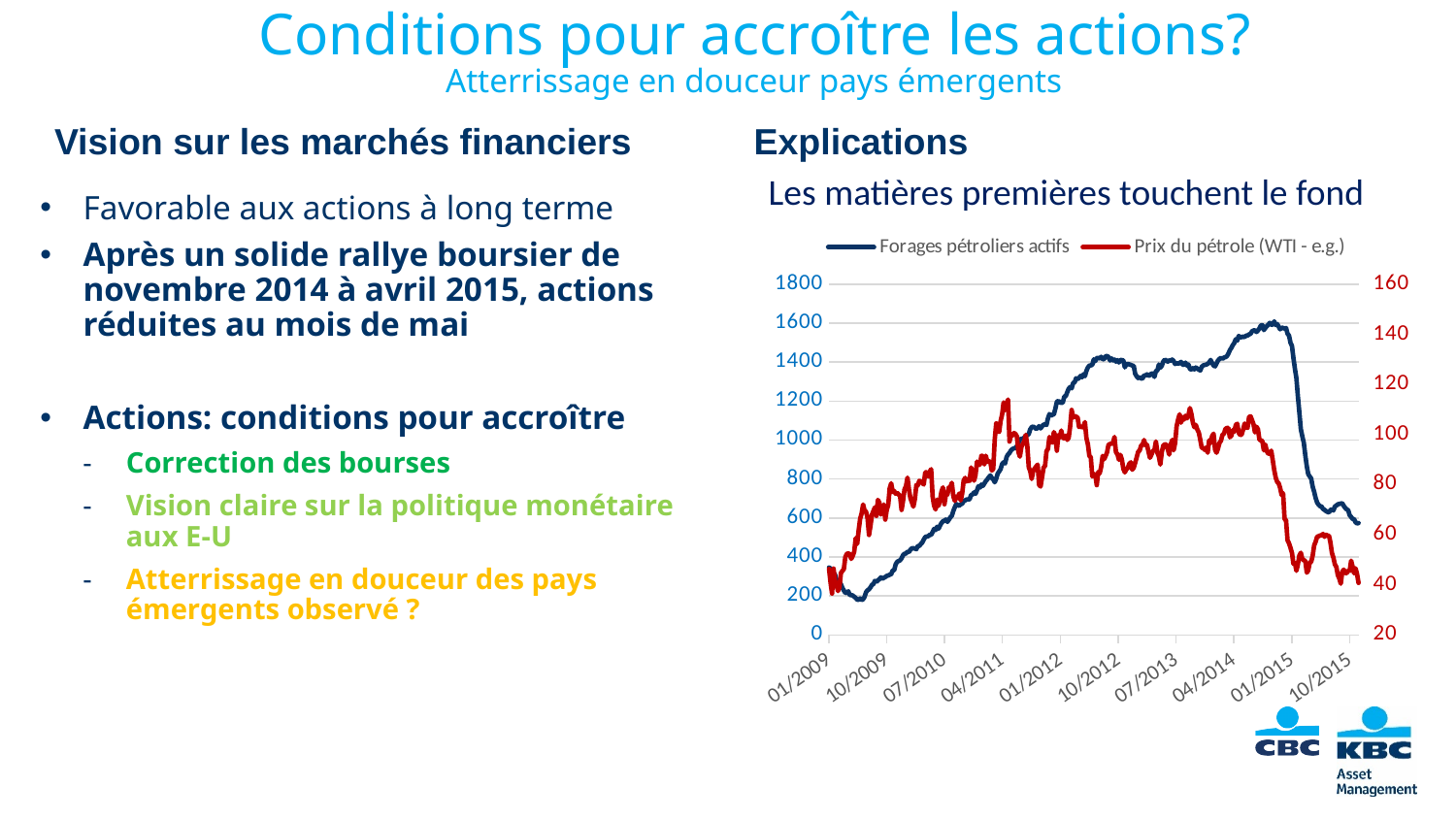
What kind of chart is shown on the slide? line chart Is the value of Forages pétroliers actifs at 10/2012 greater or less than 1200? greater What is the highest value shown on the left vertical axis of the chart? 1800 Is the value of Prix du pétrole (WTI - e.g.) at 10/2015 greater or less than 60? less Does the Forages pétroliers actifs series rise or fall overall between 10/2009 and 04/2014? rise How many series does the chart legend list? 2 How many date labels are shown on the x axis of the chart? 10 Does the Forages pétroliers actifs series rise or fall between 01/2015 and 10/2015? fall Is the value of Forages pétroliers actifs at 10/2015 greater or less than 800? less Which series is drawn in red in the chart? Prix du pétrole (WTI - e.g.) What is the title of the chart? Les matières premières touchent le fond